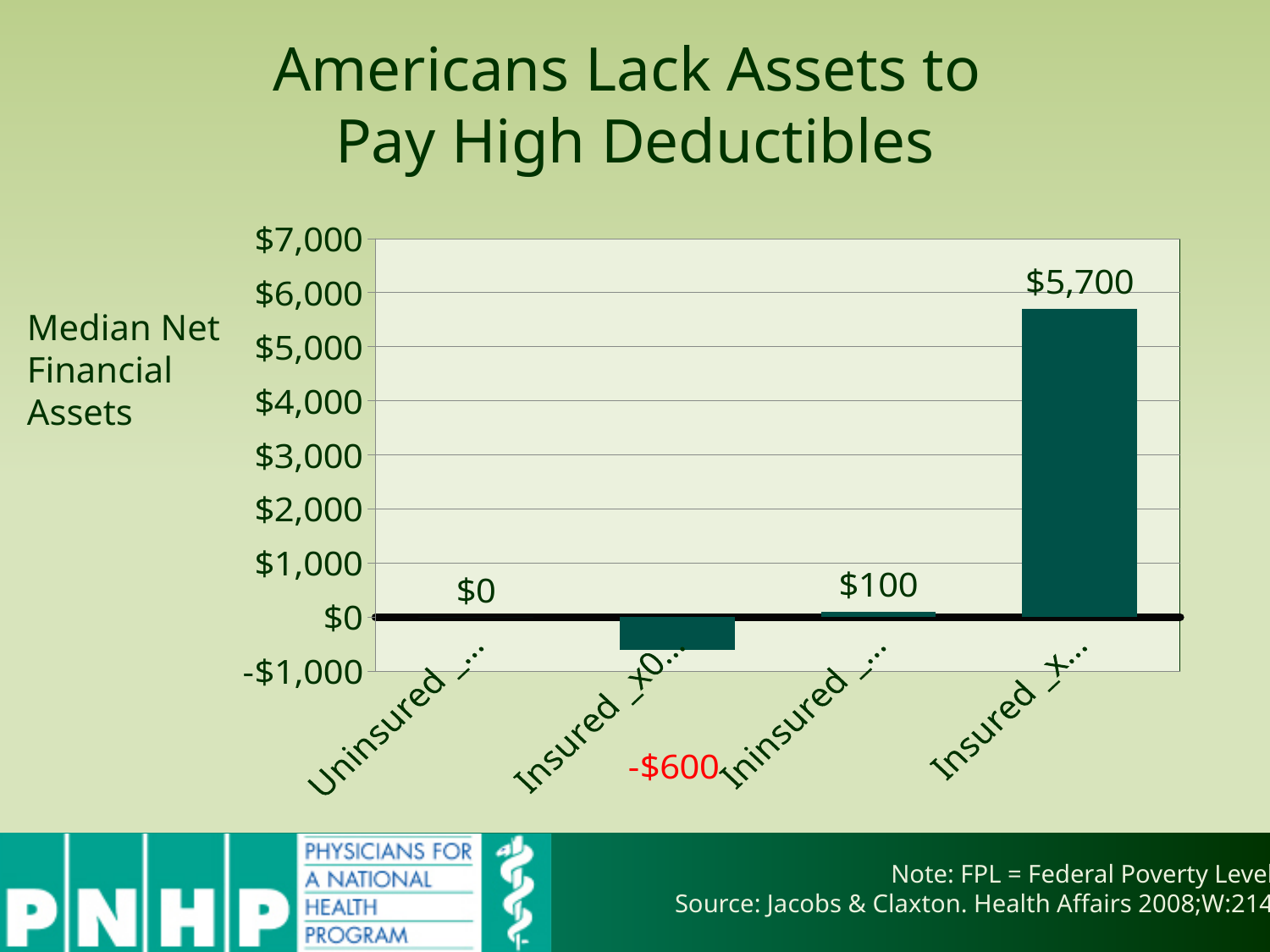
What type of chart is shown on the slide? bar chart Which bar has the highest value in the chart? the fourth (rightmost) bar, $5,700 Which is larger: the value of the second bar or the value of the third bar? the third bar ($100) What is the difference between the highest value ($5,700) and the third bar's value ($100)? $5,600 Is the value of the rightmost bar greater or less than $5,000? greater What is the value of the second bar from the left in the chart? -$600 What quantity does the chart's vertical axis represent, according to the label to the left of the chart? Median Net Financial Assets What is the value of the first (leftmost) bar in the chart? $0 How many bars (categories) are plotted in the chart? 4 Which bar has the lowest value in the chart? the second bar, -$600 What is the value of the third bar from the left in the chart? $100 What is the value of the fourth (rightmost) bar in the chart? $5,700